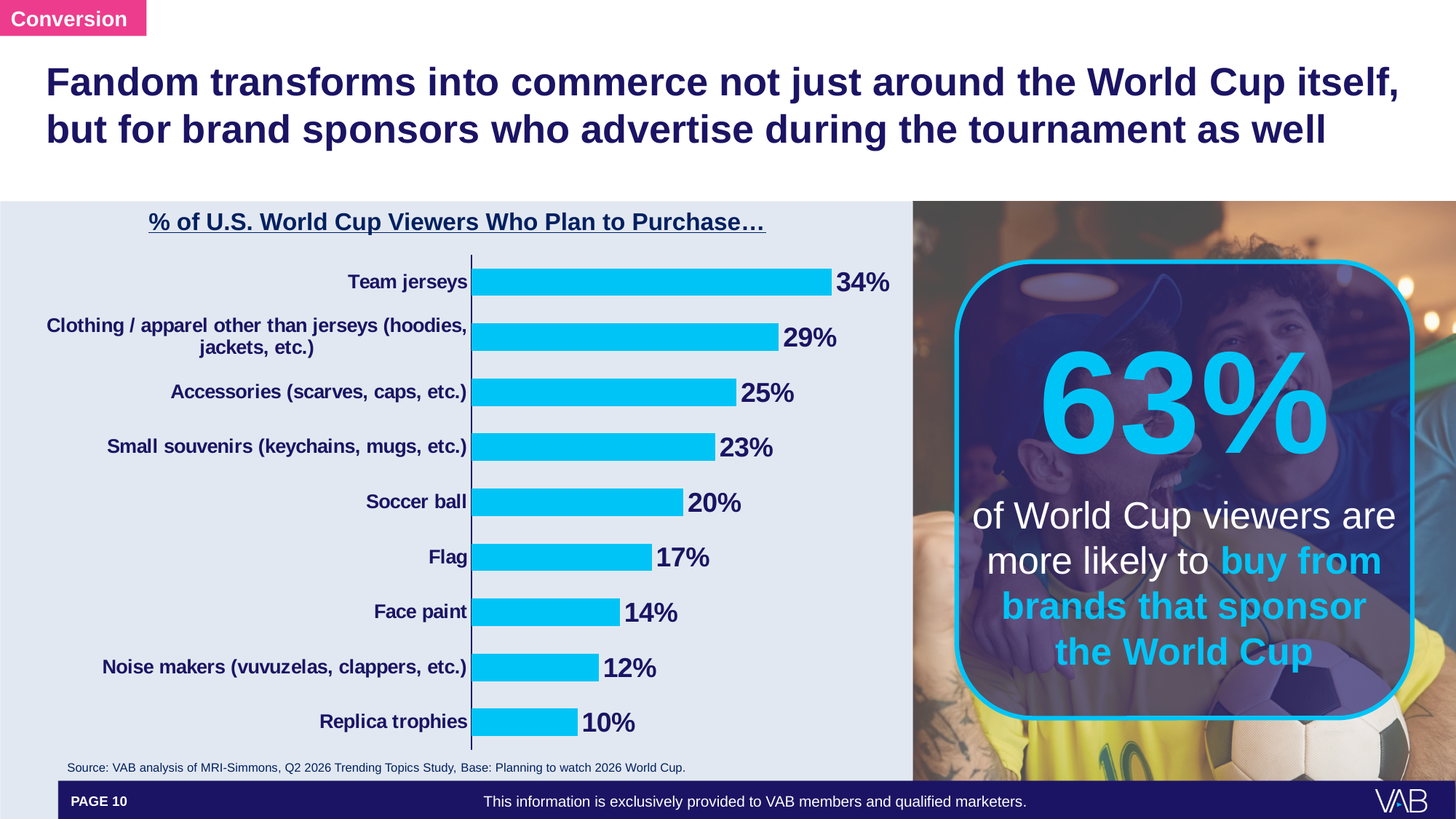
What is the difference between the percentage for Team jerseys and the percentage for Replica trophies? 24% What percentage of U.S. World Cup viewers plan to purchase team jerseys? 34% How many categories are shown in the bar chart? 9 What is the title of the chart? % of U.S. World Cup Viewers Who Plan to Purchase… What colour are the bars in the chart? Light blue Which category has the lowest percentage of viewers planning to purchase? Replica trophies What kind of chart is used to show the percentage of viewers who plan to purchase each item? Bar chart What is the difference between the values for Accessories (scarves, caps, etc.) and Small souvenirs (keychains, mugs, etc.)? 2% Which is larger: the value for Flag or the value for Face paint? Flag What percentage of viewers plan to purchase noise makers (vuvuzelas, clappers, etc.)? 12% Which category has the highest percentage of viewers planning to purchase? Team jerseys What is the value for Soccer ball in the chart? 20%